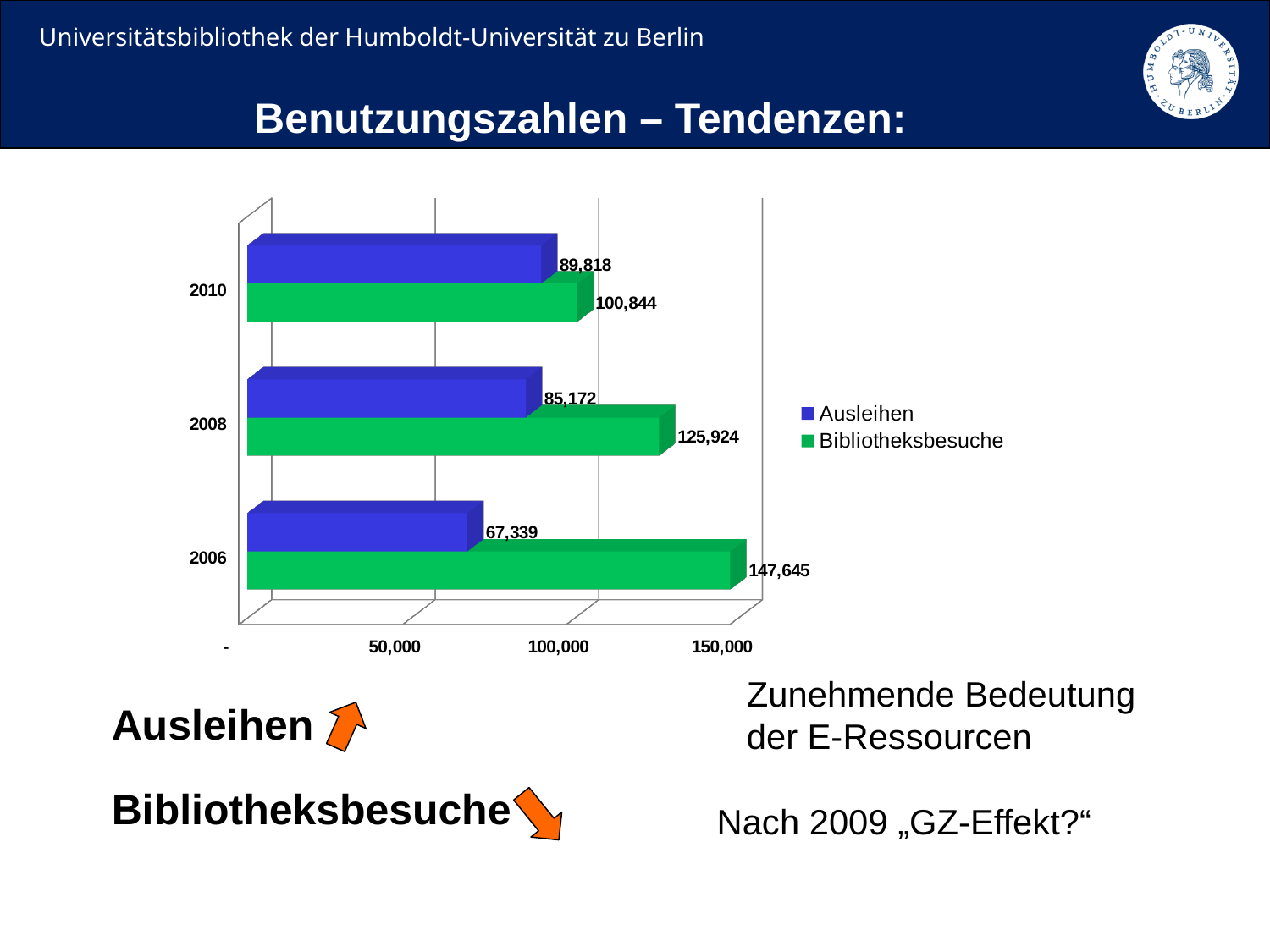
What is the value for Ausleihen in 2010? 89,818 Is the value for Bibliotheksbesuche in 2006 greater or less than 100,000? greater What is the difference between Bibliotheksbesuche and Ausleihen in 2010? 11,026 What is the value for Ausleihen in 2006? 67,339 Which year has the lowest value for Ausleihen? 2006 Which is larger in 2008, Ausleihen or Bibliotheksbesuche? Bibliotheksbesuche Which year has the highest value for Bibliotheksbesuche? 2006 How many series does the legend list? 2 What is the value for Bibliotheksbesuche in 2008? 125,924 What kind of chart is shown on the slide? bar chart What is the value for Bibliotheksbesuche in 2006? 147,645 How many years are shown on the chart? 3